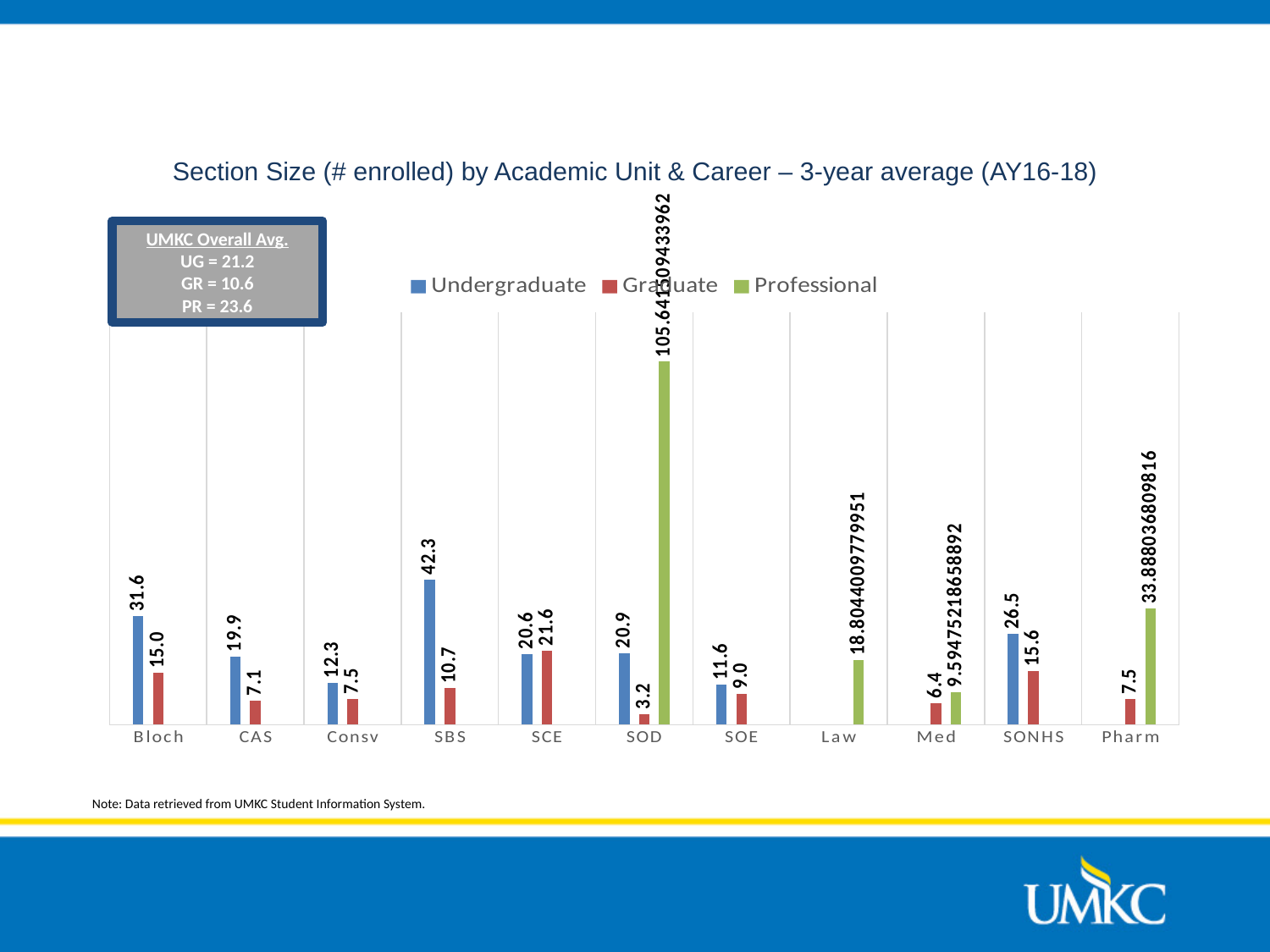
Which academic unit has the lowest Graduate value? SOD What is the Professional value for Law? 18.8044009779951 What is the Graduate value for SCE? 21.6 What is the difference between the Undergraduate and Graduate values for SBS? 31.6 For SCE, which is larger: the Undergraduate value or the Graduate value? Graduate What is the Undergraduate value for Bloch? 31.6 What kind of chart is shown on the slide? Bar chart What is the difference between the Undergraduate and Graduate values for Bloch? 16.6 Which academic unit has the highest Undergraduate value? SBS How many academic units are shown on the x axis? 11 What is the Professional value for SOD? 105.641509433962 How many series does the legend list? 3